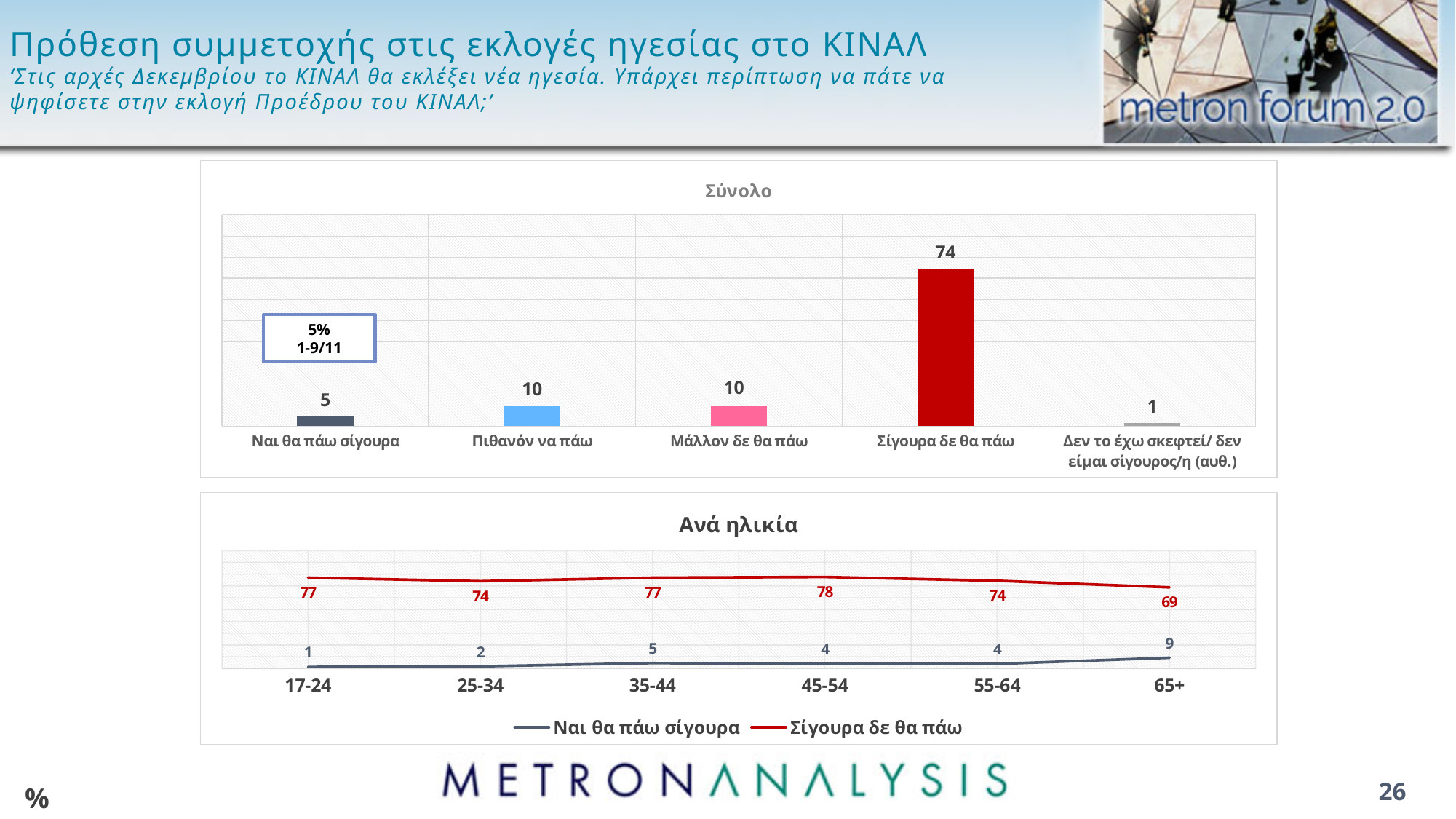
In the 'Σύνολο' chart, what is the value for 'Σίγουρα δε θα πάω'? 74 In the 'Ανά ηλικία' chart, what is the value of 'Σίγουρα δε θα πάω' for the 65+ age group? 69 In the 'Σύνολο' chart, what is the difference between 'Σίγουρα δε θα πάω' and 'Πιθανόν να πάω'? 64 In the 'Σύνολο' chart, which category has the lowest value? Δεν το έχω σκεφτεί/ δεν είμαι σίγουρος/η (αυθ.) In the 'Σύνολο' chart, how many categories are shown? 5 In the 'Ανά ηλικία' chart, which age group has the highest value for 'Σίγουρα δε θα πάω'? 45-54 In the 'Σύνολο' chart, which category has the highest value? Σίγουρα δε θα πάω In the 'Ανά ηλικία' chart, how many series does the legend list? 2 In the 'Ανά ηλικία' chart, what is the difference between 'Σίγουρα δε θα πάω' and 'Ναι θα πάω σίγουρα' for the 17-24 age group? 76 In the 'Σύνολο' chart, what is the value for 'Ναι θα πάω σίγουρα'? 5 What kind of chart is the 'Σύνολο' chart? bar chart In the 'Ανά ηλικία' chart, what is the value of 'Ναι θα πάω σίγουρα' for the 35-44 age group? 5